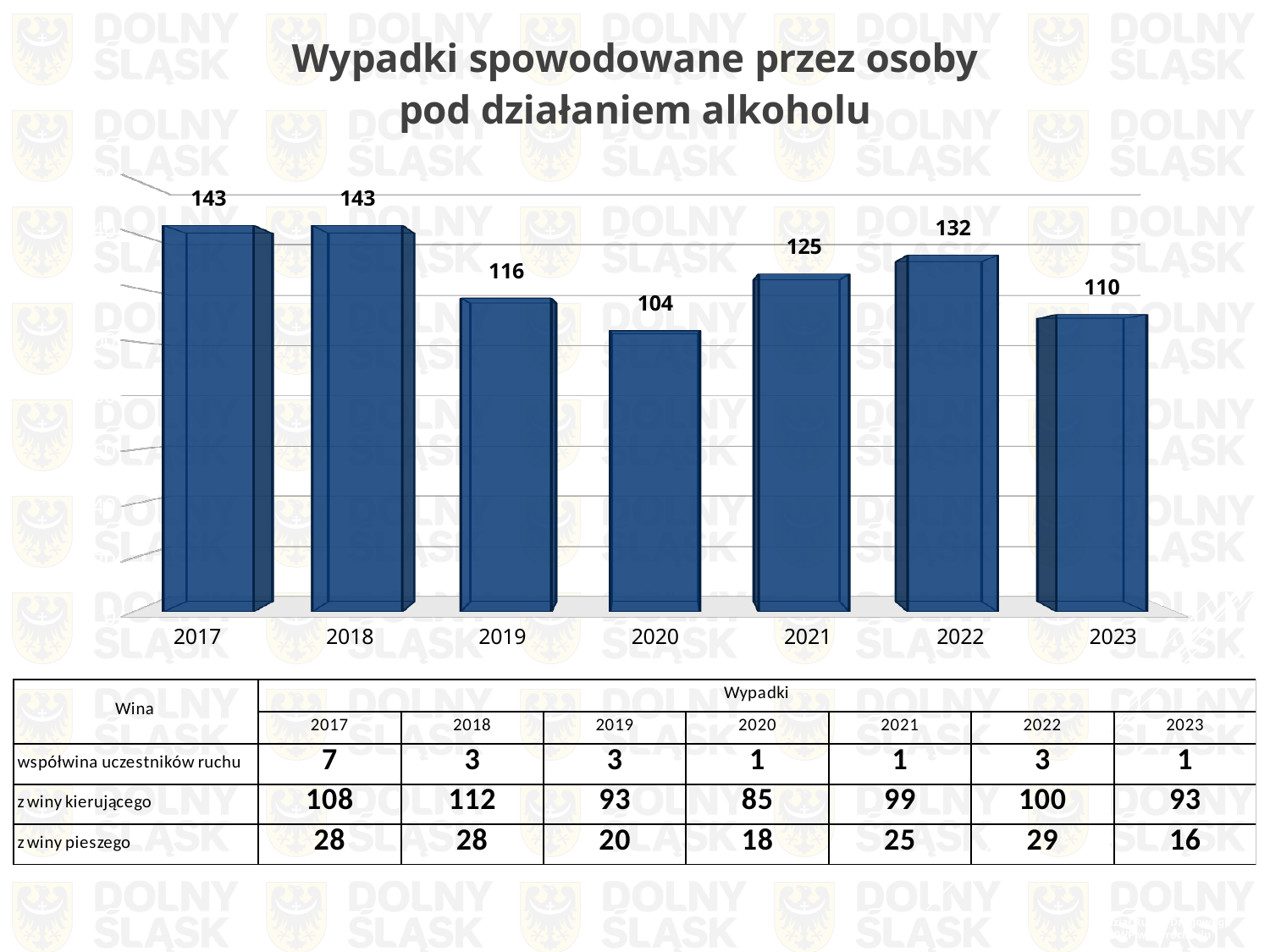
What is the value for 2019 in the chart? 116 What is the difference between the values for 2018 and 2020? 39 What is the difference between the values for 2022 and 2023? 22 What is the value for 2021 in the chart? 125 What is the title of the chart? Wypadki spowodowane przez osoby pod działaniem alkoholu Which is larger, the value for 2021 or the value for 2019? 2021 Do the values rise or fall from 2020 to 2022? rise Which year has the lowest value in the chart? 2020 How many years are shown on the x axis of the chart? 7 What kind of chart is shown on the slide? bar chart What is the value for 2023 in the chart? 110 What is the value for 2022 in the chart? 132